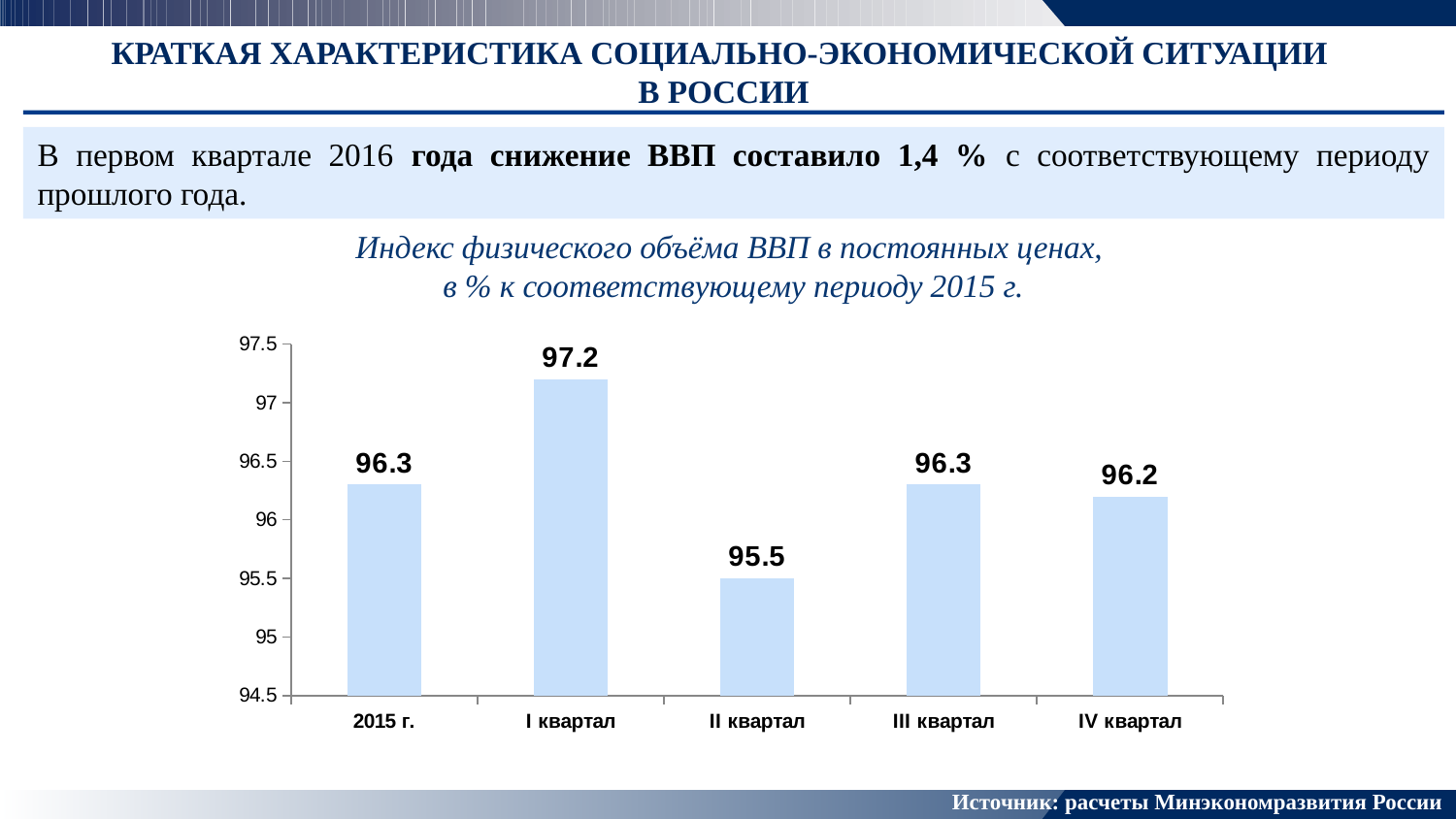
What is the value for II квартал? 95.5 Is the value for II квартал greater or less than 96? less Which is larger, the value for III квартал or the value for IV квартал? III квартал What kind of chart is shown on the slide? bar chart What is the value for I квартал? 97.2 What is the title of the chart? Индекс физического объёма ВВП в постоянных ценах, в % к соответствующему периоду 2015 г. Which category has the highest value? I квартал What is the difference between the values for I квартал and II квартал? 1.7 What is the value for 2015 г.? 96.3 How many categories are shown on the x axis? 5 What is the value for IV квартал? 96.2 Which category has the lowest value? II квартал